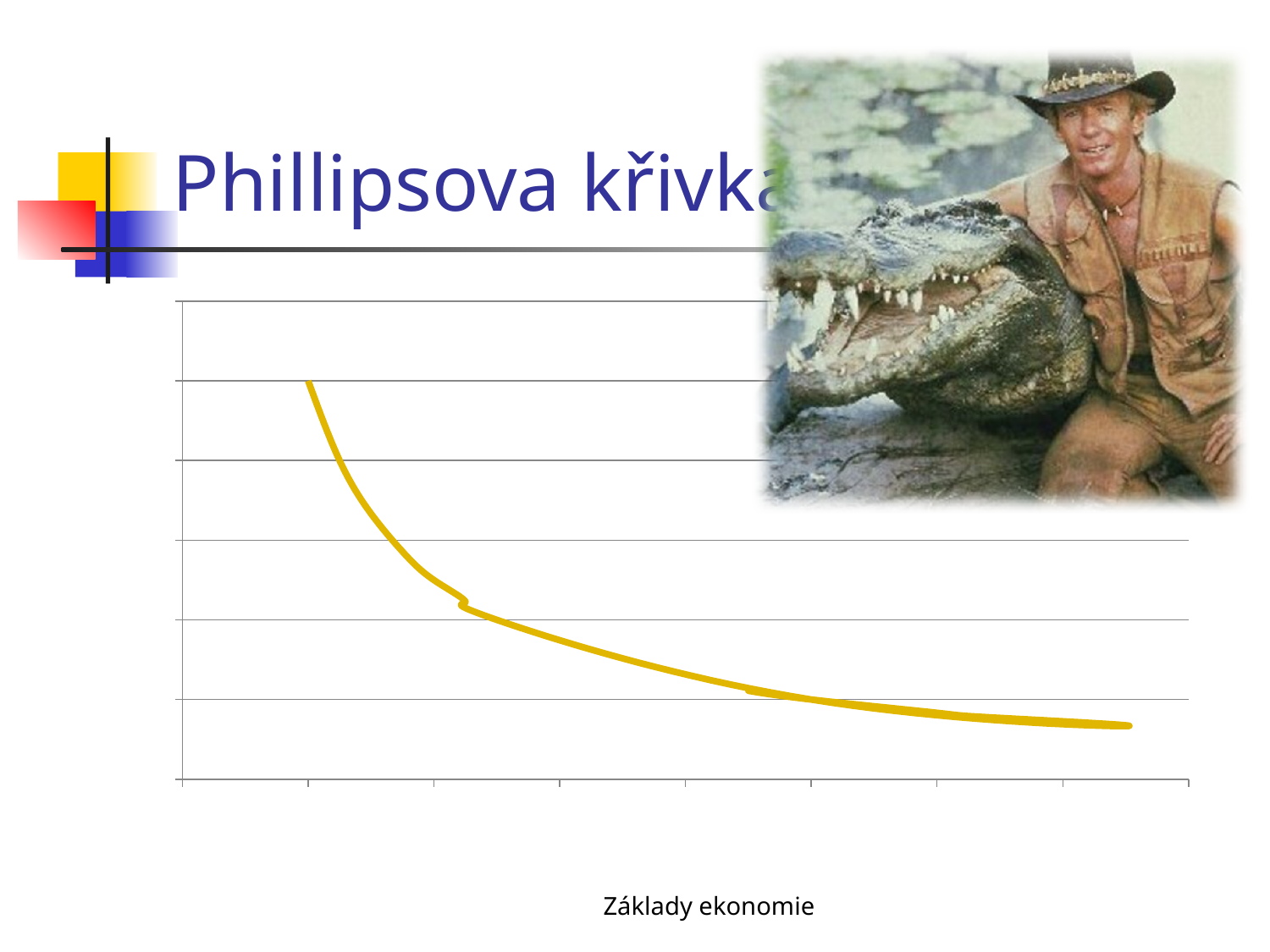
What colour is the plotted line on the chart? yellow How many lines (series) are plotted on the chart? 1 Do the values of the plotted line rise or fall from left to right along the x axis? fall What kind of chart is shown on the slide? line chart Is the plotted line steeper at its left end or at its right end? left end What is the title shown on the slide above the chart? Phillipsova křivka